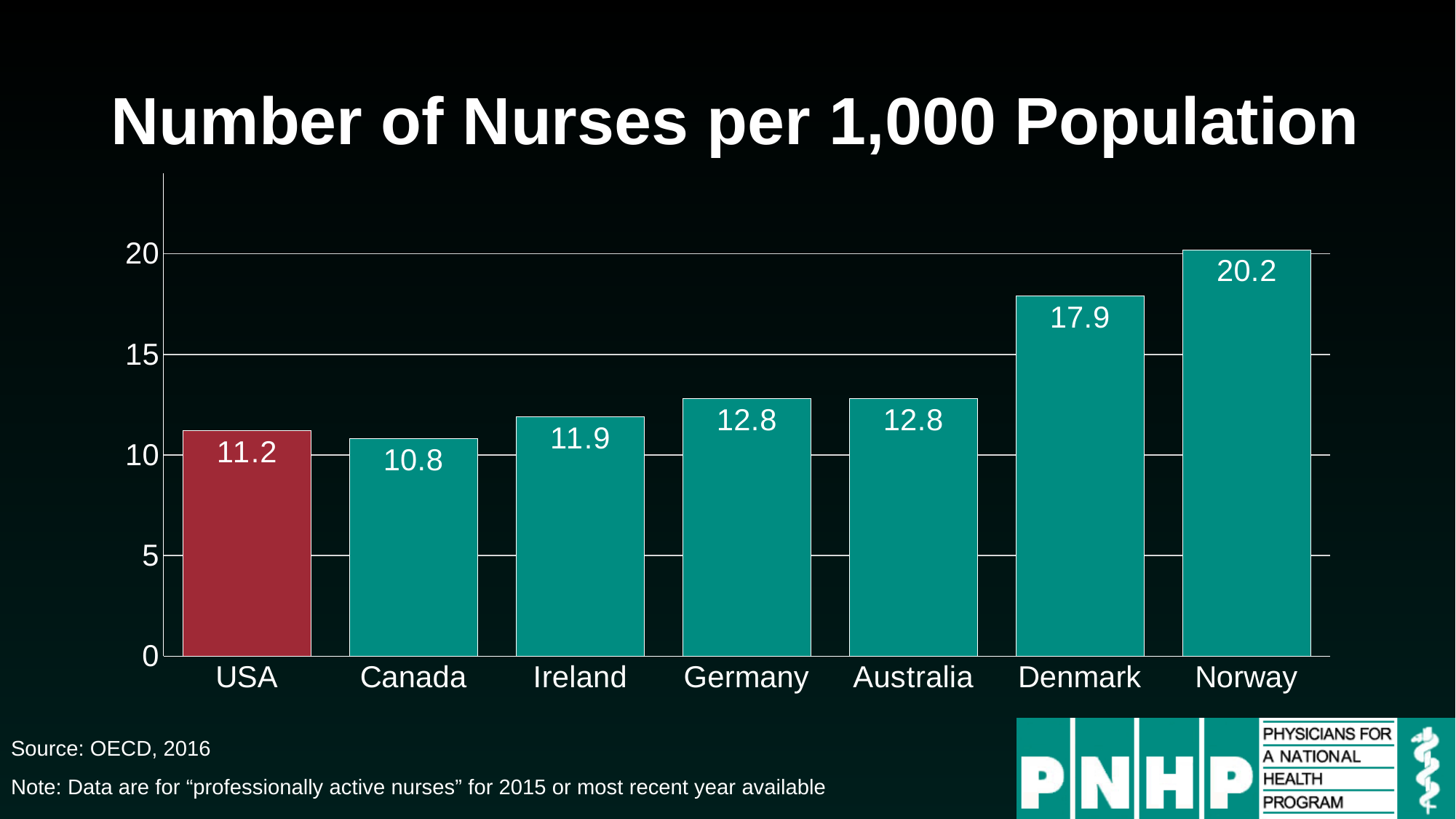
Which country's bar is coloured differently (red) from the others? USA What is the number of nurses per 1,000 population for the USA? 11.2 What is the difference between Denmark's value and Ireland's value? 6.0 Which has a higher value, Ireland or Germany? Germany Which country has the lowest number of nurses per 1,000 population? Canada What is the value shown for Canada? 10.8 What is the difference between Norway's value and the USA's value? 9.0 How many countries are shown in the chart? 7 What is the value shown for Denmark? 17.9 What kind of chart is shown on the slide? Bar chart Which country has the highest number of nurses per 1,000 population? Norway Is the value for Norway greater or less than 20? greater